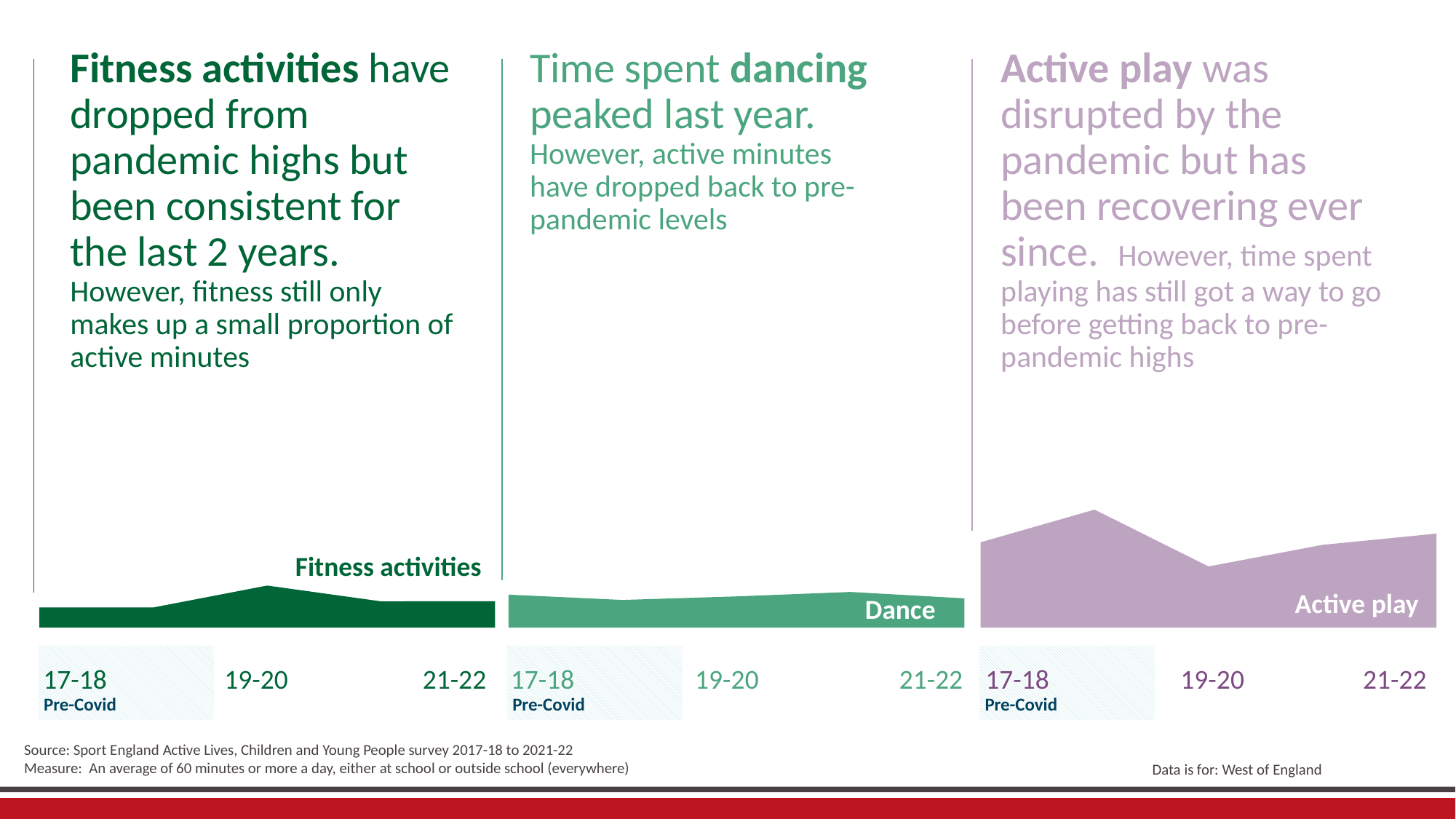
In the Fitness activities chart, which labelled year has the highest value? 19-20 In the Fitness activities chart, is the value for 21-22 larger or smaller than the value for 19-20? smaller In the Active play chart, which labelled year has the lowest value? 19-20 What kind of chart is the Fitness activities chart? area chart Which year on the x axis is labelled Pre-Covid? 17-18 In the Fitness activities chart, is the value for 19-20 larger or smaller than the value for 17-18? larger In the Active play chart, do values rise or fall from 19-20 to 21-22? rise How many charts are shown on the slide? 3 In the Active play chart, is the value for 17-18 larger or smaller than the value for 19-20? larger How many year labels are shown on the x axis of the Dance chart? 3